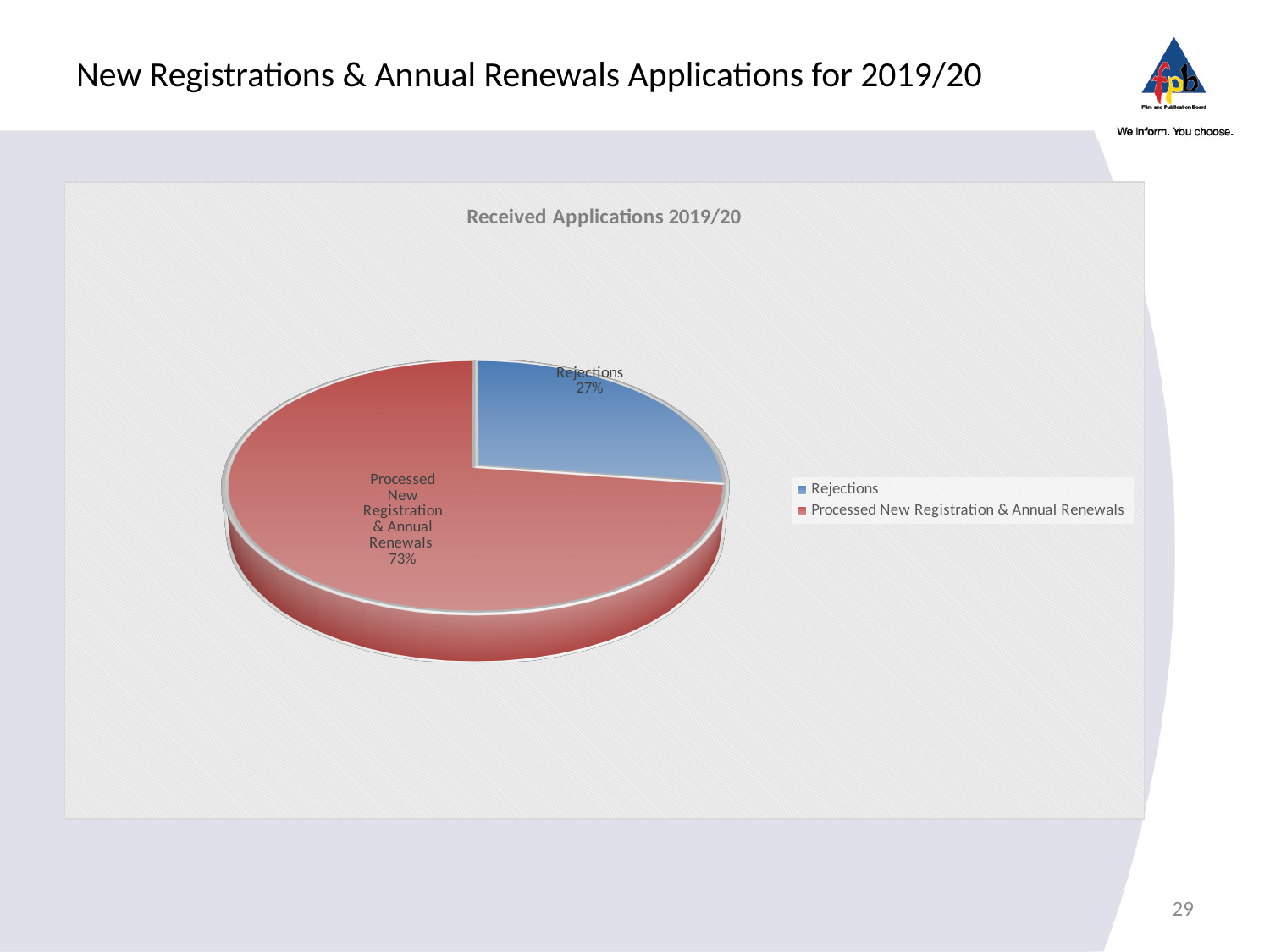
How many entries does the legend list? 2 What kind of chart is shown on the slide? Pie chart Which slice is the largest? Processed New Registration & Annual Renewals Which slice is the smallest? Rejections What share of the pie is Processed New Registration & Annual Renewals? 73% What is the title of the chart? Received Applications 2019/20 What colour is the Rejections slice? Blue What share of the pie is Rejections? 27% Which is larger, the Rejections slice or the Processed New Registration & Annual Renewals slice? Processed New Registration & Annual Renewals What is the difference in percentage points between the Processed New Registration & Annual Renewals slice and the Rejections slice? 46 How many slices does the pie chart have? 2